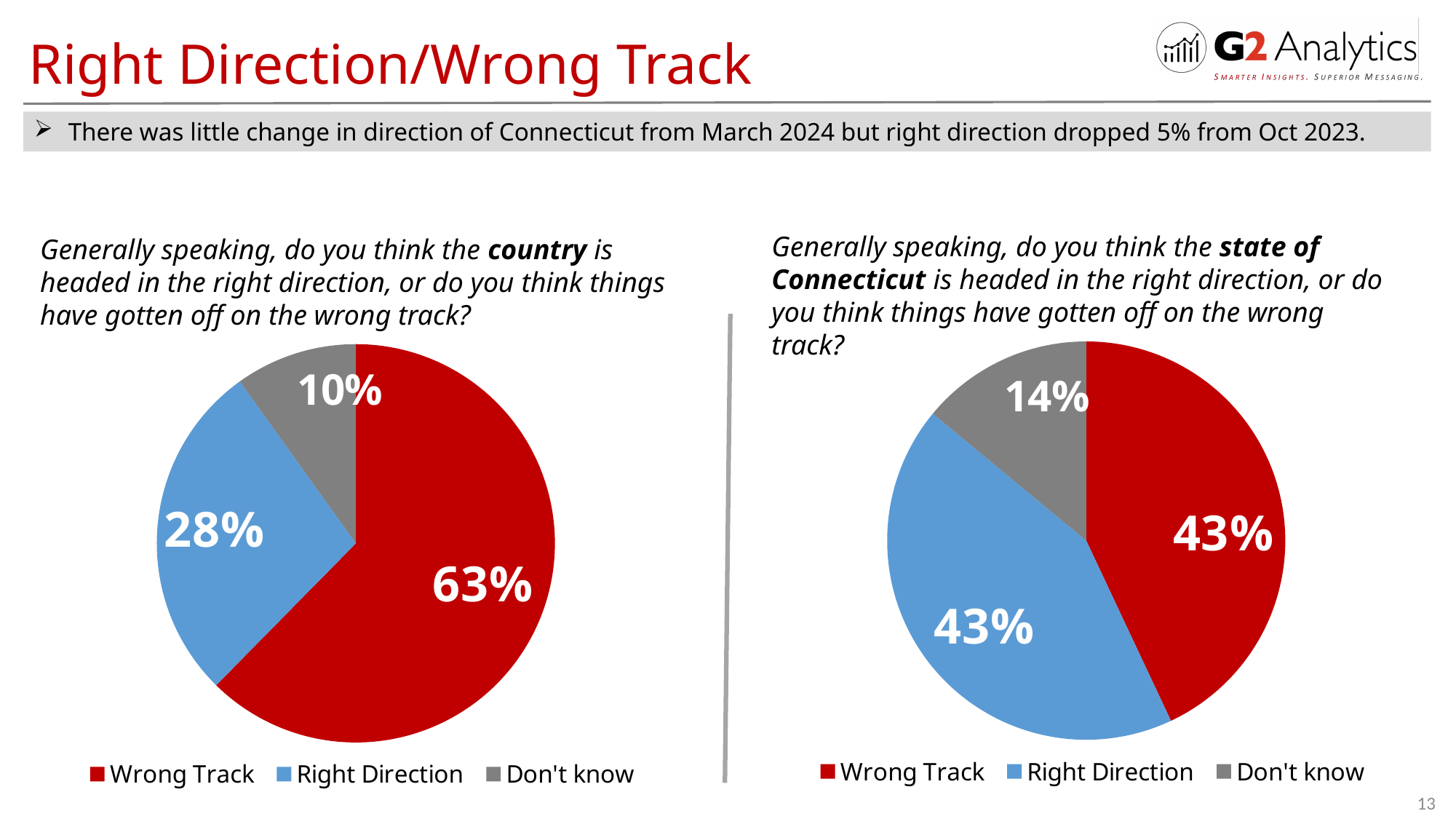
In the left pie chart about the country, what percentage of respondents said Wrong Track? 63% In the right pie chart about the state of Connecticut, what percentage of respondents said Don't know? 14% In the left pie chart about the country, what percentage of respondents said Don't know? 10% In the left pie chart about the country, what percentage of respondents said Right Direction? 28% How many categories does the legend of the right pie chart list? 3 In the right pie chart about the state of Connecticut, which response has the smallest share? Don't know In the left pie chart about the country, which response has the largest share? Wrong Track In the left pie chart about the country, what is the difference between the Wrong Track and Right Direction shares? 35% In the right pie chart about the state of Connecticut, what is the difference between the Right Direction and Don't know shares? 29% In the left pie chart about the country, which response has the smallest share? Don't know What kind of chart is used on the left side of the slide? Pie chart In the right pie chart about the state of Connecticut, what percentage of respondents said Wrong Track? 43%